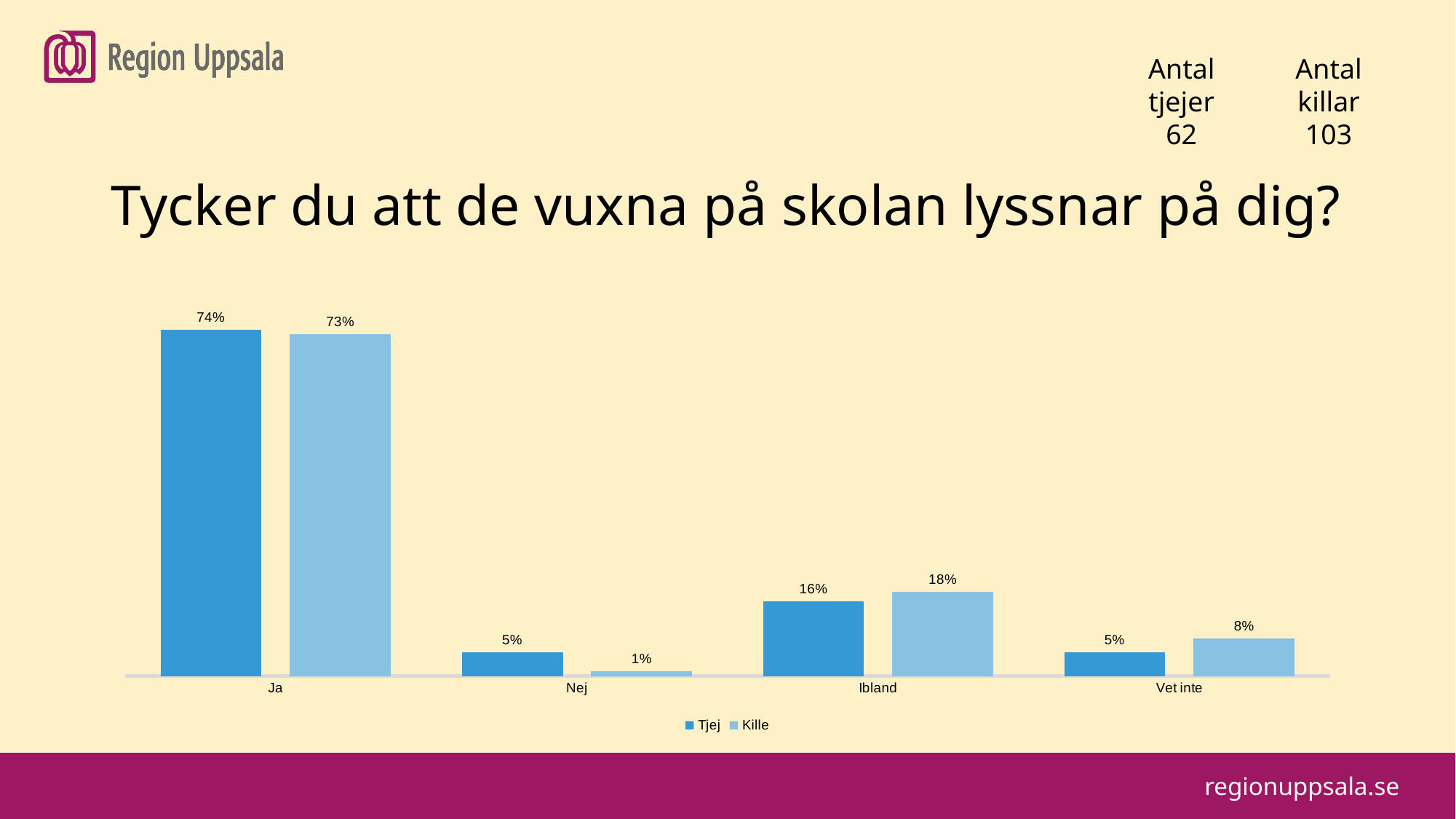
How many series does the legend list? 2 What is the value for Tjej in the Vet inte category? 5% What is the value for Kille in the Ibland category? 18% What is the value for Tjej in the Ja category? 74% Which category has the highest value for Kille? Ja What is the difference between the Tjej and Kille values in the Nej category? 4% In the Vet inte category, which series has the larger value, Tjej or Kille? Kille What is the value for Kille in the Nej category? 1% What is the difference between the Kille and Tjej values in the Ibland category? 2% How many categories are shown on the x axis? 4 What kind of chart is shown on the slide? Bar chart Which category has the lowest value for Kille? Nej